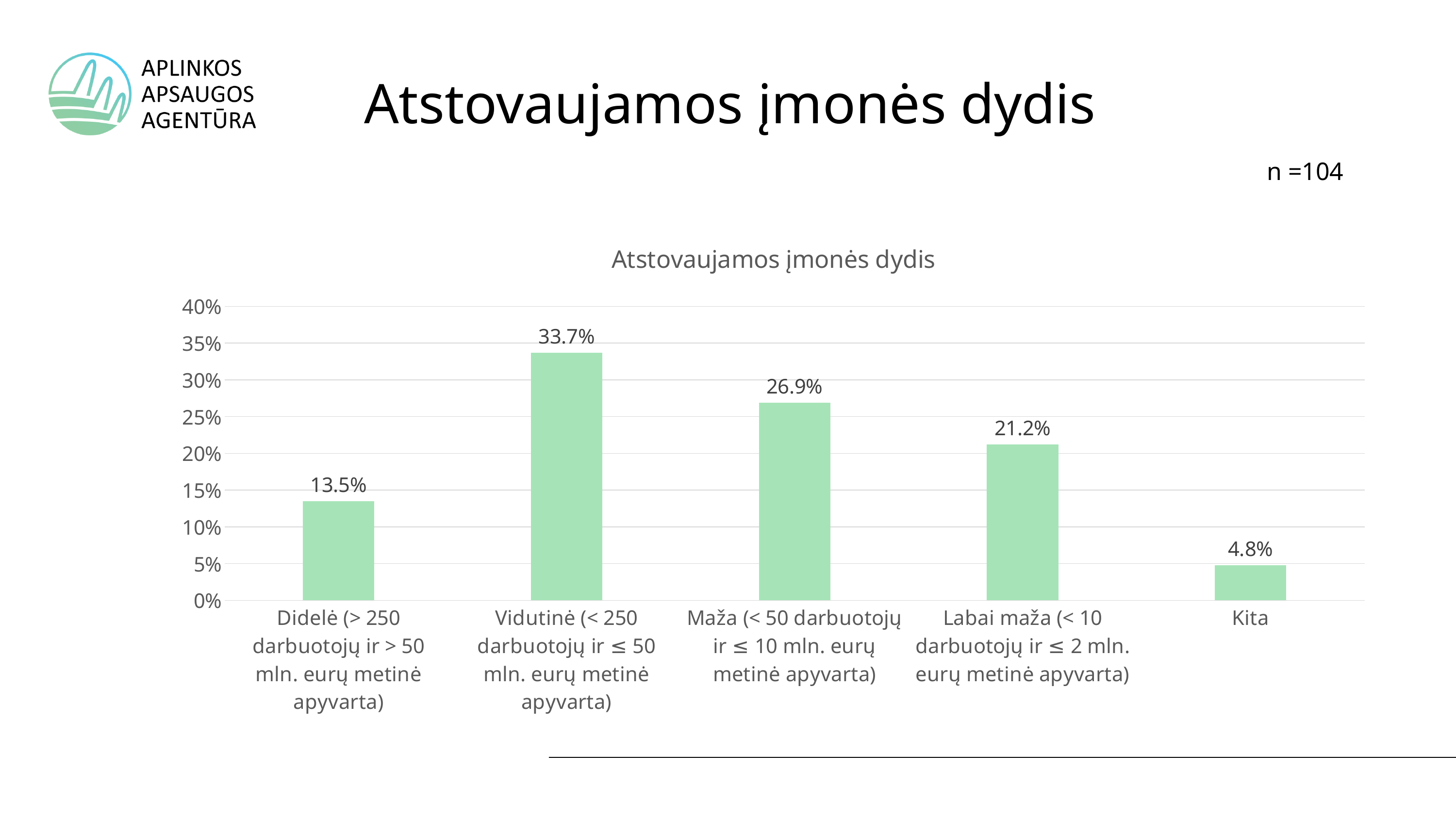
Which is larger, the value for Didelė or the value for Labai maža? Labai maža What kind of chart is shown on the slide? bar chart Is the value for Maža (< 50 darbuotojų ir ≤ 10 mln. eurų metinė apyvarta) greater or less than 25%? greater What is the difference between the values for Vidutinė and Maža? 6.8% What is the value for Kita? 4.8% Which category has the lowest value? Kita How many categories are shown on the x axis? 5 Which category has the highest value? Vidutinė (< 250 darbuotojų ir ≤ 50 mln. eurų metinė apyvarta) What is the value for Labai maža (< 10 darbuotojų ir ≤ 2 mln. eurų metinė apyvarta)? 21.2% What is the title of the chart? Atstovaujamos įmonės dydis What is the value for Vidutinė (< 250 darbuotojų ir ≤ 50 mln. eurų metinė apyvarta)? 33.7% What is the value for Didelė (> 250 darbuotojų ir > 50 mln. eurų metinė apyvarta)? 13.5%